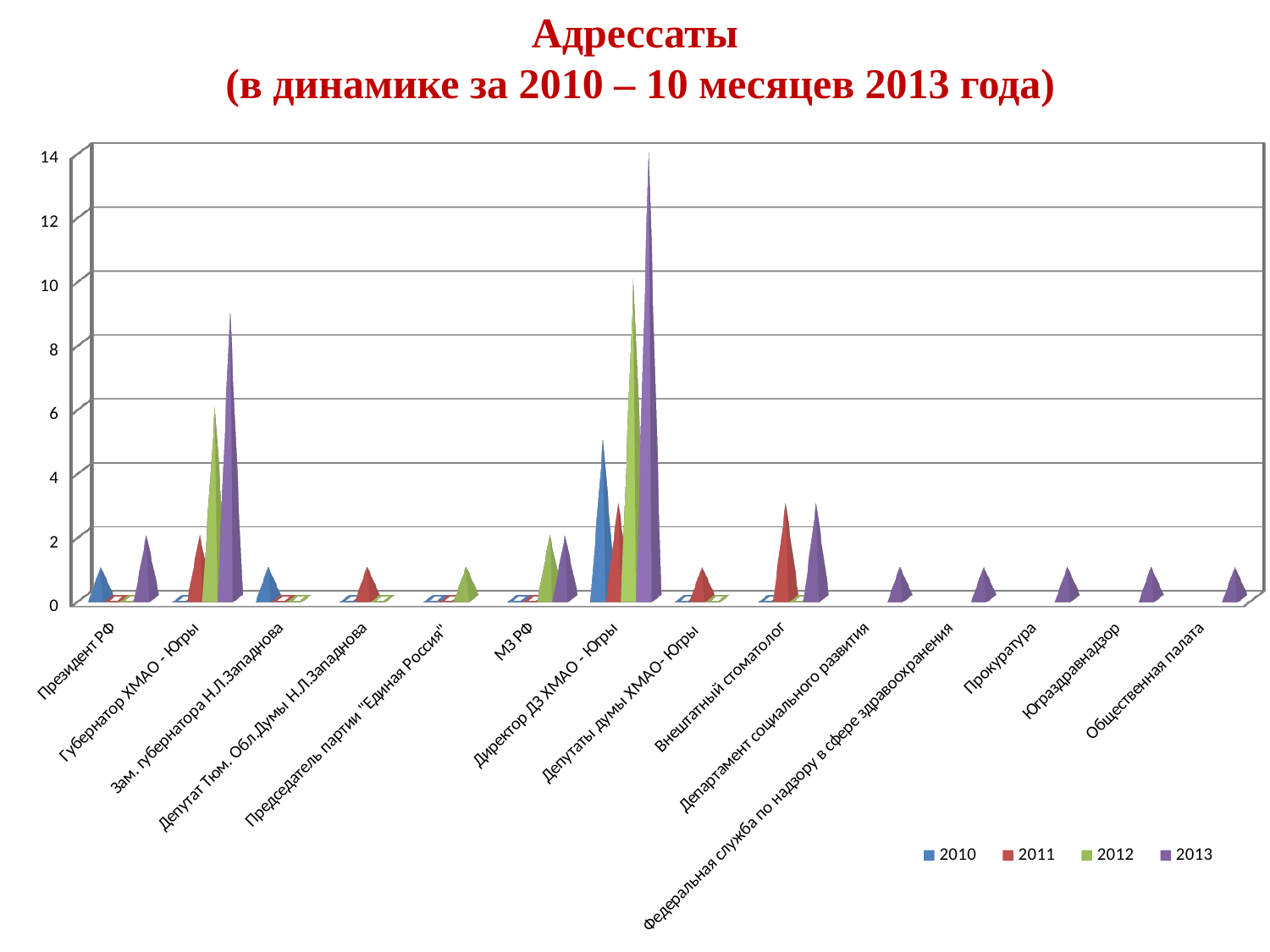
How many categories are shown on the x axis? 14 What is the title of the chart? Адрессаты (в динамике за 2010 – 10 месяцев 2013 года) How many series does the legend list? 4 Is the 2011 value for Внештатный стоматолог greater or less than 2? greater For Губернатор ХМАО - Югры, which series has the larger value, 2012 or 2013? 2013 Is the 2013 value for Губернатор ХМАО - Югры greater or less than 6? greater What kind of chart is shown on the slide? bar chart Is the 2012 value for Директор ДЗ ХМАО - Югры greater or less than 8? greater For Директор ДЗ ХМАО - Югры, which series has the larger value, 2012 or 2013? 2013 Which category has the highest value for the 2013 series? Директор ДЗ ХМАО - Югры